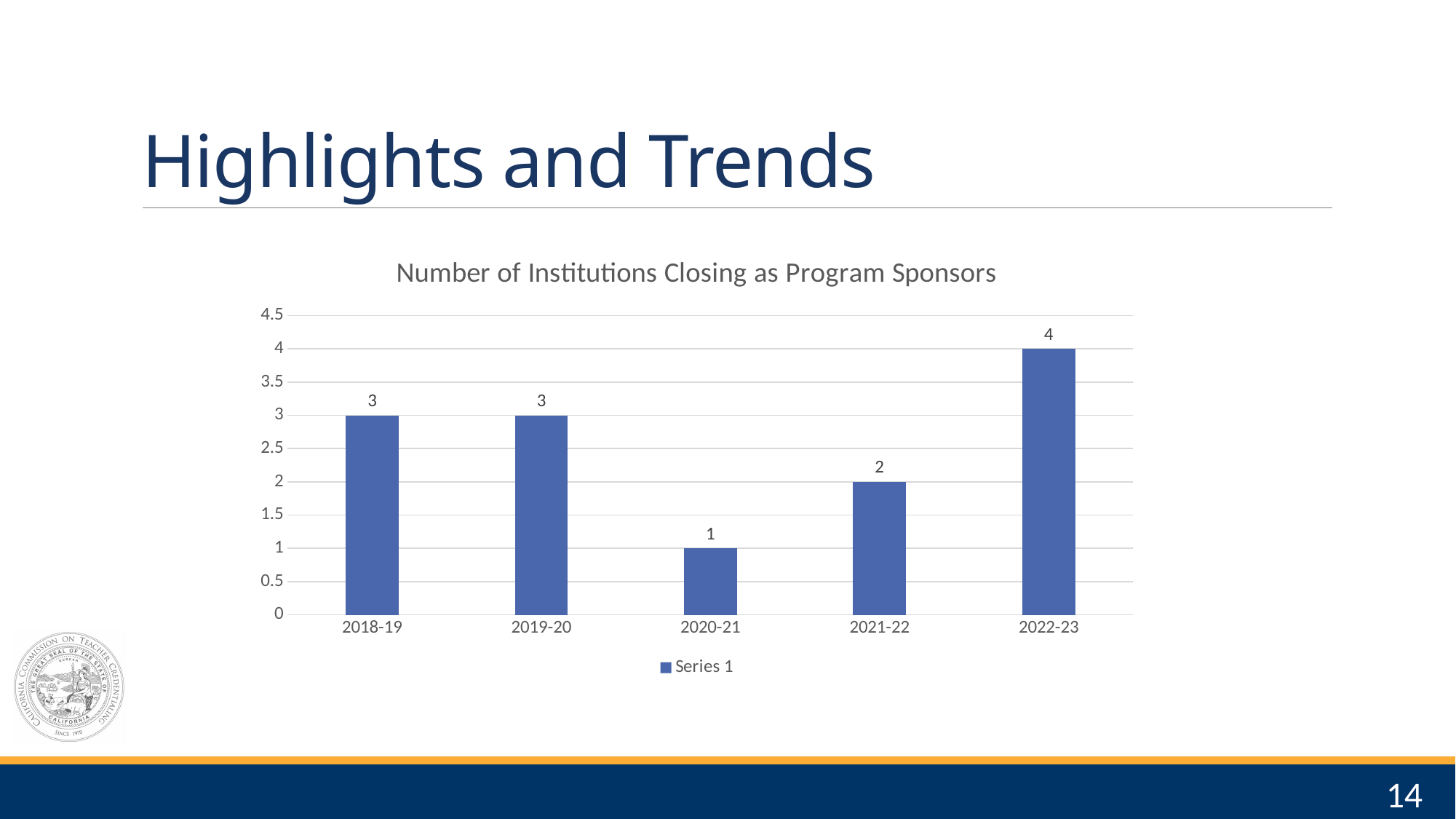
How many years are shown on the x axis? 5 What is the title of the chart? Number of Institutions Closing as Program Sponsors What kind of chart is shown on the slide? Bar chart Which year has the lowest number of institutions closing as program sponsors? 2020-21 What is the value for 2020-21? 1 Which year has the highest number of institutions closing as program sponsors? 2022-23 What is the difference between the values for 2022-23 and 2020-21? 3 Which is larger, the value for 2021-22 or the value for 2019-20? 2019-20 How many series does the legend list? 1 What is the value for 2022-23? 4 What is the value for 2018-19? 3 What is the value for 2021-22? 2